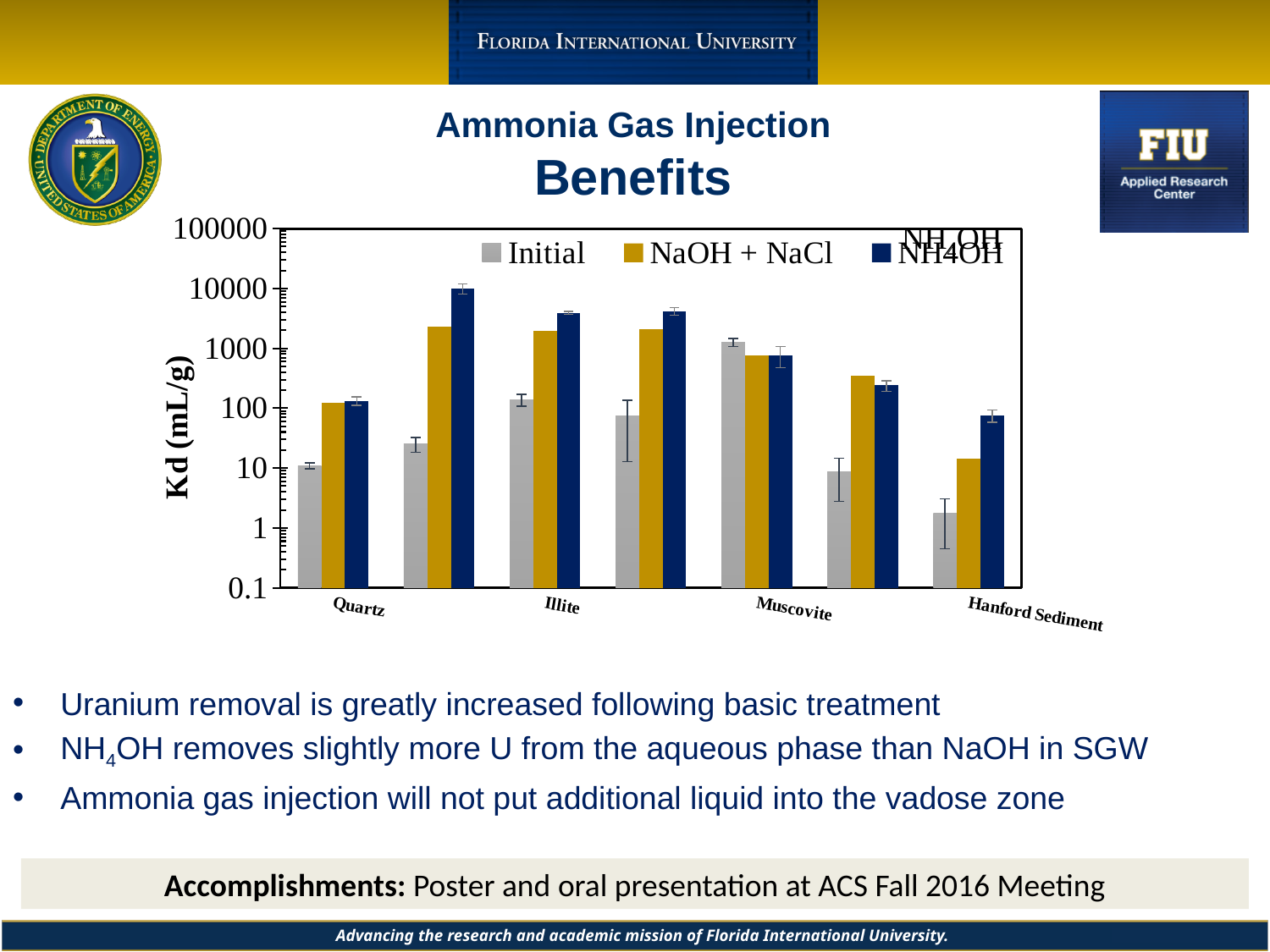
For Illite, which series has the lowest Kd value? Initial What is the label of the y-axis? Kd (mL/g) For Quartz, which is larger: the Initial value or the NH4OH value? NH4OH How many series does the chart legend list? 3 Is the Initial value for Hanford Sediment greater or less than 10? less For Hanford Sediment, which series has the highest Kd value? NH4OH Is the Initial value for Quartz greater or less than 100? less Which series is shown in gray in the legend? Initial What kind of chart is shown on the slide? Bar chart Is the NaOH + NaCl value for Illite greater or less than 1000? greater